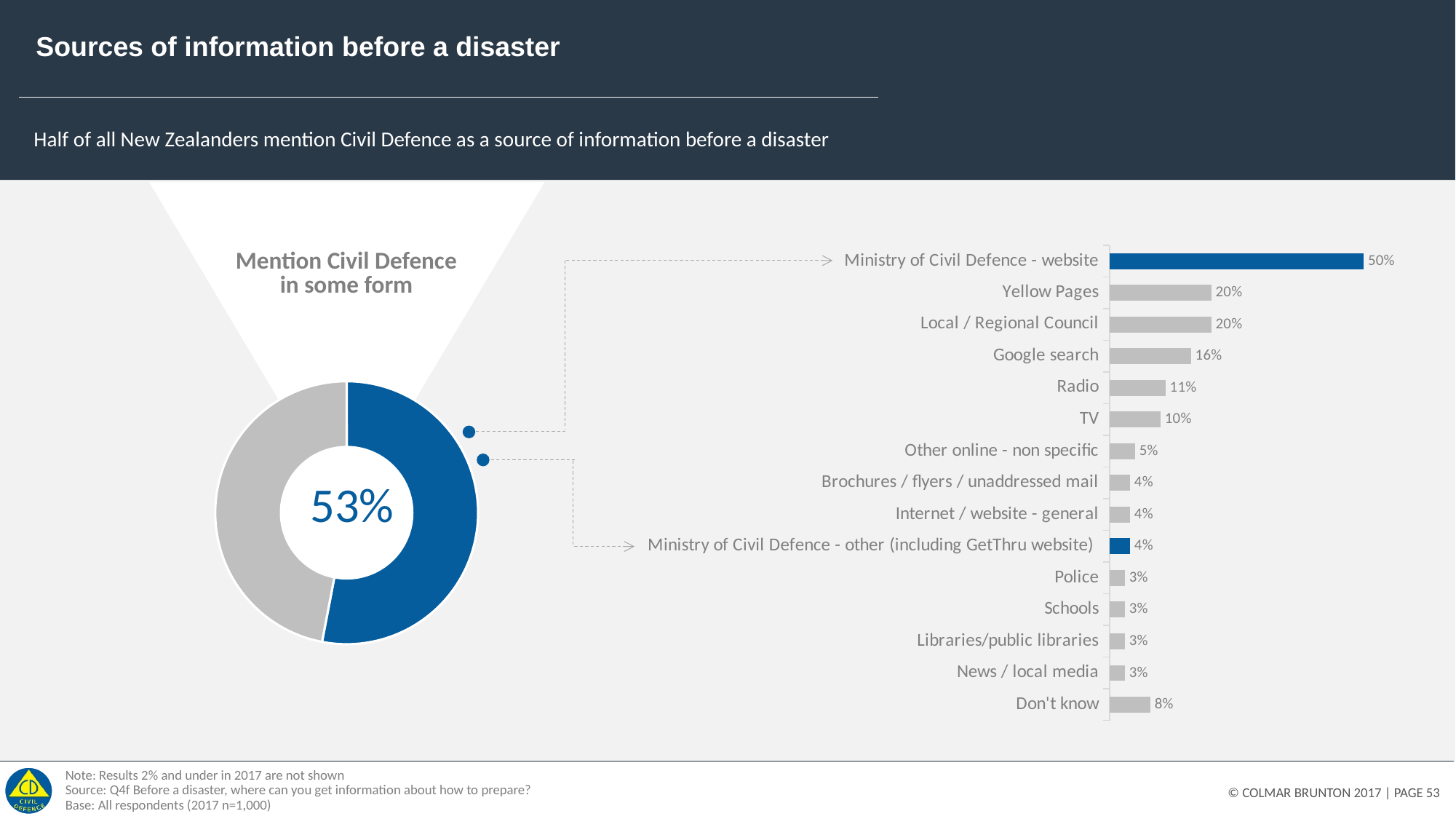
In the bar chart on the right, what is the difference between Radio and TV? 1% In the bar chart on the right, which is larger, Other online - non specific or Don't know? Don't know In the bar chart on the right, what is the difference between Ministry of Civil Defence - website and Yellow Pages? 30% In the bar chart on the right, which two categories are shown in blue? Ministry of Civil Defence - website and Ministry of Civil Defence - other (including GetThru website) In the bar chart on the right, what is the value for Google search? 16% How many categories are shown in the bar chart on the right? 15 In the donut chart on the left, what percentage mention Civil Defence in some form? 53% In the bar chart on the right, what is the value for Don't know? 8% In the bar chart on the right, what is the value for Ministry of Civil Defence - website? 50% In the bar chart on the right, which category has the highest value? Ministry of Civil Defence - website In the bar chart on the right, which is larger, Google search or Radio? Google search What kind of chart is shown on the right side of the slide? Bar chart